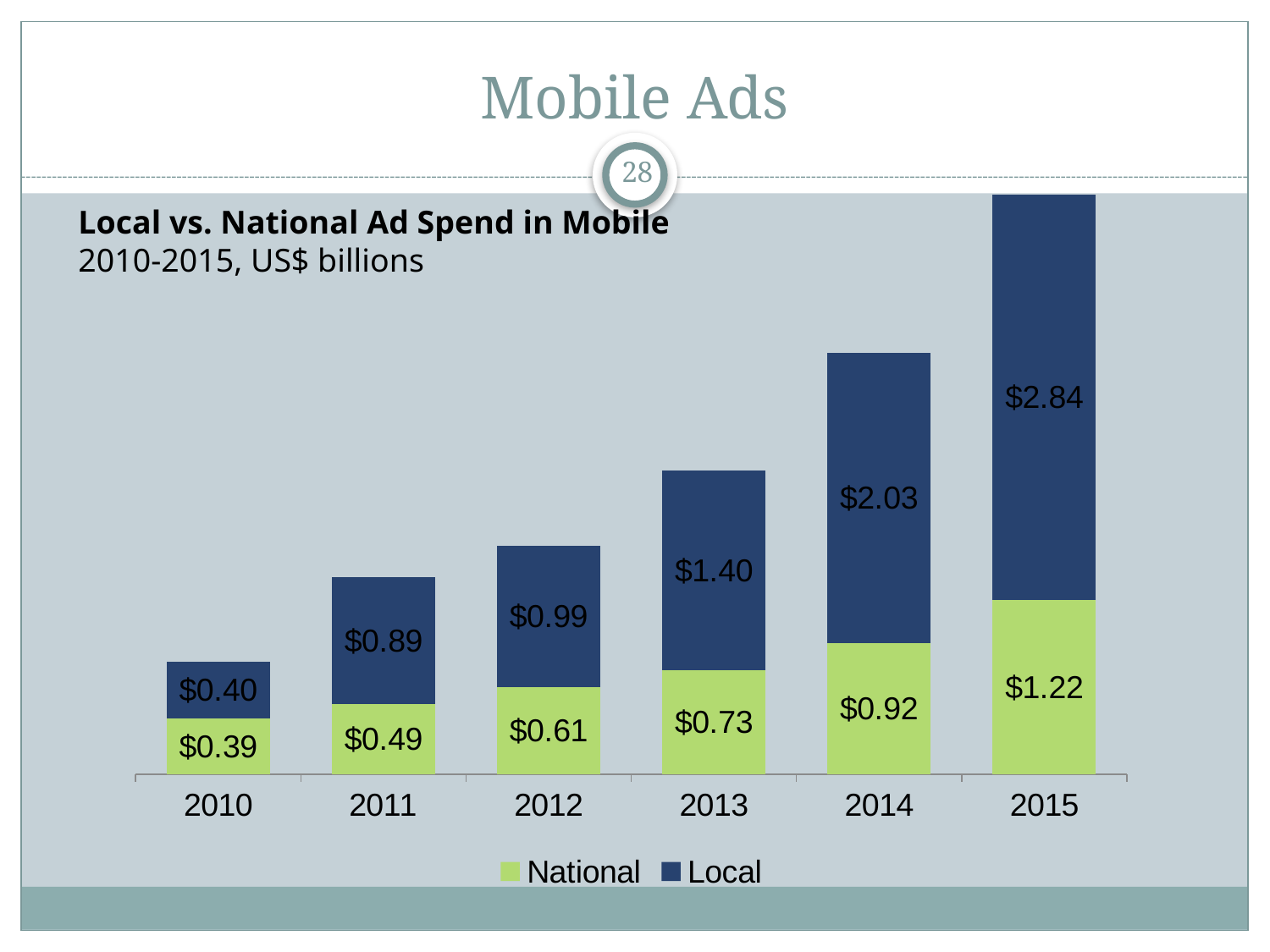
How many years are shown on the x axis? 6 Which year has the highest Local ad spend? 2015 Which is larger in 2012, the Local value or the National value? Local Which year has the lowest National ad spend? 2010 What is the title of the chart? Local vs. National Ad Spend in Mobile What is the difference between the Local and National values in 2014? $1.11 What is the total of the stacked bar for 2015? $4.06 What kind of chart is shown on the slide? Stacked bar chart What is the National ad spend value for 2011? $0.49 Do the Local values rise or fall from 2010 to 2015? Rise How many series does the legend list? 2 What is the Local ad spend value for 2013? $1.40